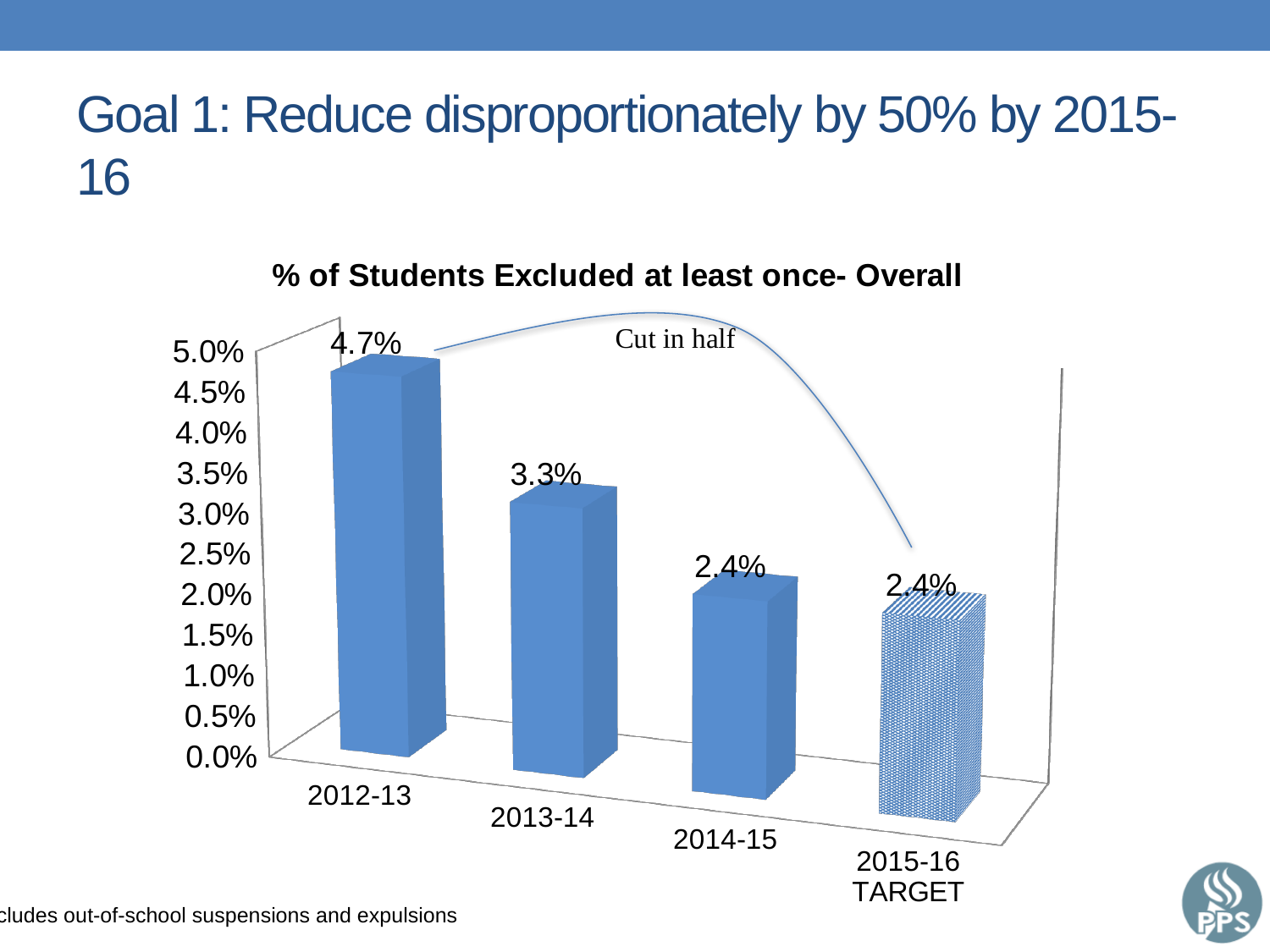
What is the value for 2012-13? 4.7% What is the value for the 2015-16 TARGET? 2.4% What is the difference between the values for 2012-13 and 2013-14? 1.4% What is the title of the chart? % of Students Excluded at least once- Overall Do the values rise or fall from 2012-13 to 2014-15? fall What kind of chart is shown on the slide? bar chart What is the value for 2014-15? 2.4% What is the value for 2013-14? 3.3% How many categories are shown on the x axis? 4 Which is larger, the value for 2013-14 or the value for 2014-15? 2013-14 Which category has the highest value? 2012-13 What is the difference between the values for 2012-13 and 2014-15? 2.3%